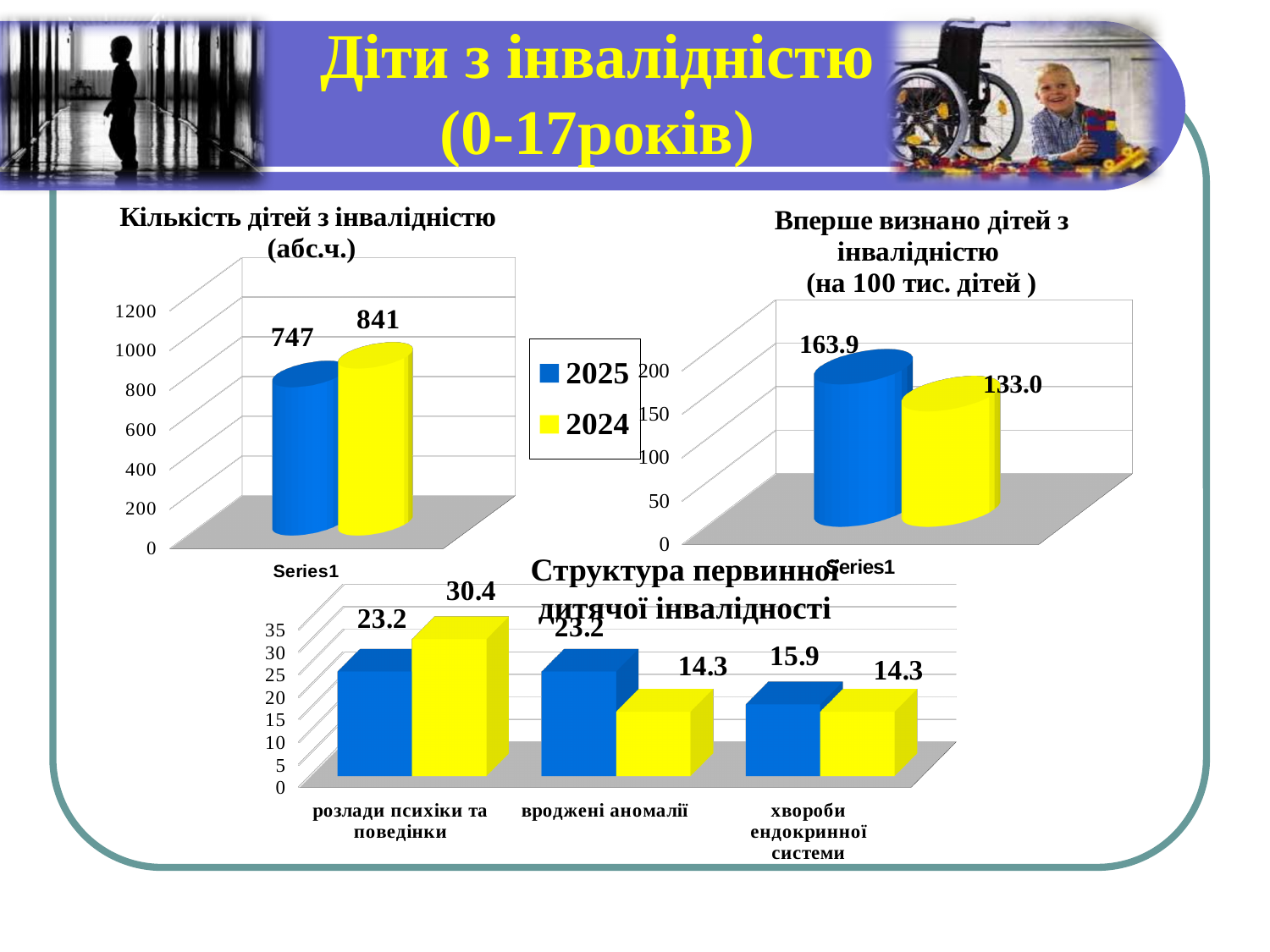
In the chart 'Структура первинної дитячої інвалідності', what is the 2024 value for 'розлади психіки та поведінки'? 30.4 In the chart 'Вперше визнано дітей з інвалідністю (на 100 тис. дітей)', which year has the larger value, 2025 or 2024? 2025 In the chart 'Кількість дітей з інвалідністю (абс.ч.)', what is the value for 2025? 747 In the chart 'Структура первинної дитячої інвалідності', which category has the highest 2024 value? розлади психіки та поведінки In the chart 'Кількість дітей з інвалідністю (абс.ч.)', what is the difference between the 2024 and 2025 values? 94 In the chart 'Вперше визнано дітей з інвалідністю (на 100 тис. дітей)', what is the value for 2025? 163.9 In the chart 'Структура первинної дитячої інвалідності', what is the 2025 value for 'хвороби ендокринної системи'? 15.9 In the chart 'Кількість дітей з інвалідністю (абс.ч.)', what is the value for 2024? 841 In the chart 'Структура первинної дитячої інвалідності', how many categories are shown on the x axis? 3 What kind of chart is 'Структура первинної дитячої інвалідності'? bar chart How many series does the legend on the slide list? 2 In the chart 'Вперше визнано дітей з інвалідністю (на 100 тис. дітей)', what is the difference between the 2025 and 2024 values? 30.9